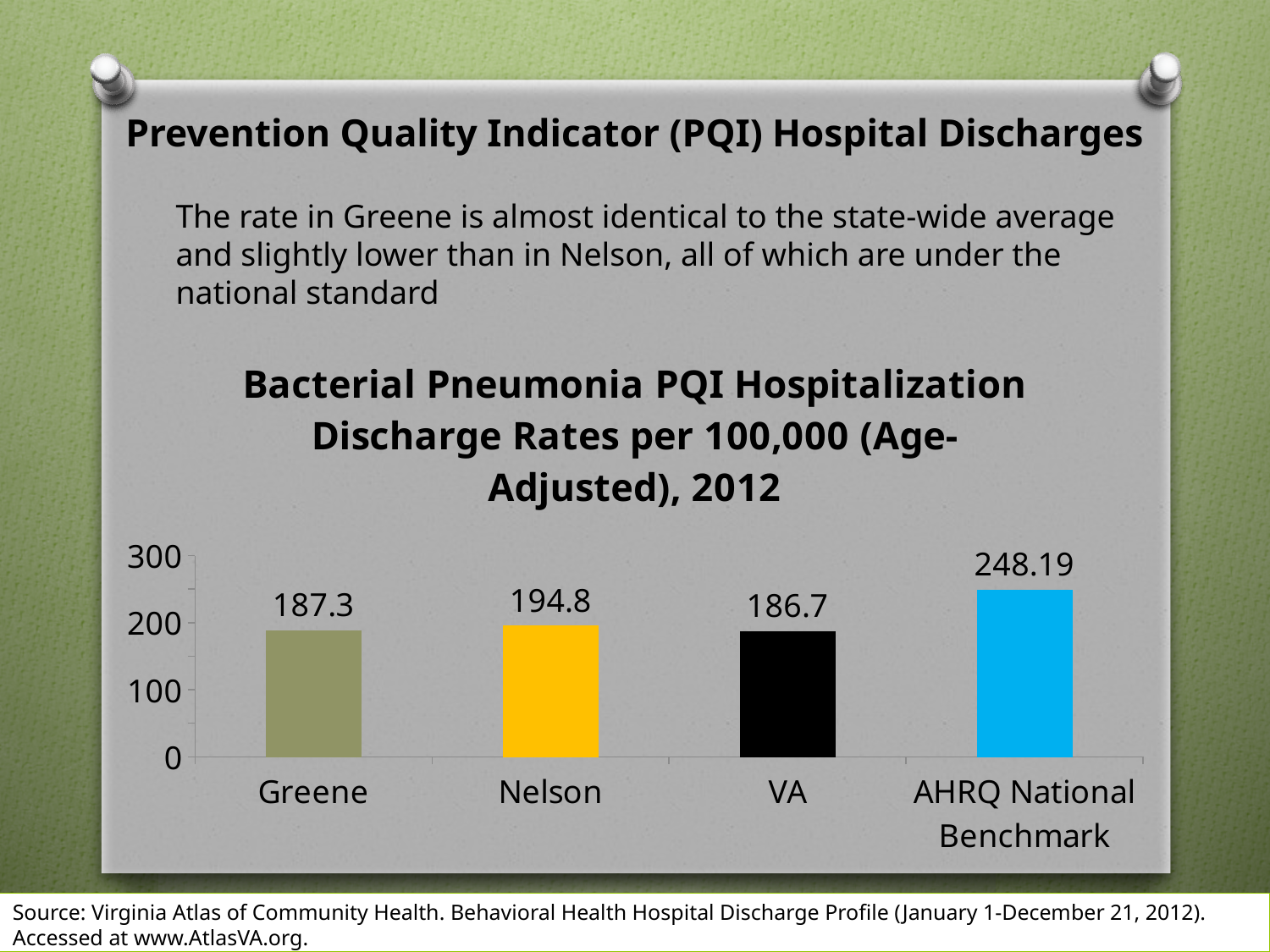
Which category has the highest discharge rate? AHRQ National Benchmark Which is larger, the value for Nelson or the value for Greene? Nelson What is the title of the chart? Bacterial Pneumonia PQI Hospitalization Discharge Rates per 100,000 (Age-Adjusted), 2012 What is the Bacterial Pneumonia PQI hospitalization discharge rate for Greene? 187.3 What is the value shown for Nelson? 194.8 What is the value shown for VA? 186.7 What kind of chart is shown on the slide? bar chart What is the value shown for the AHRQ National Benchmark? 248.19 What is the difference between the Nelson value and the Greene value? 7.5 Is the value for the AHRQ National Benchmark greater or less than 200? greater How many categories are shown on the x axis of the chart? 4 What is the difference between the AHRQ National Benchmark value and the VA value? 61.49